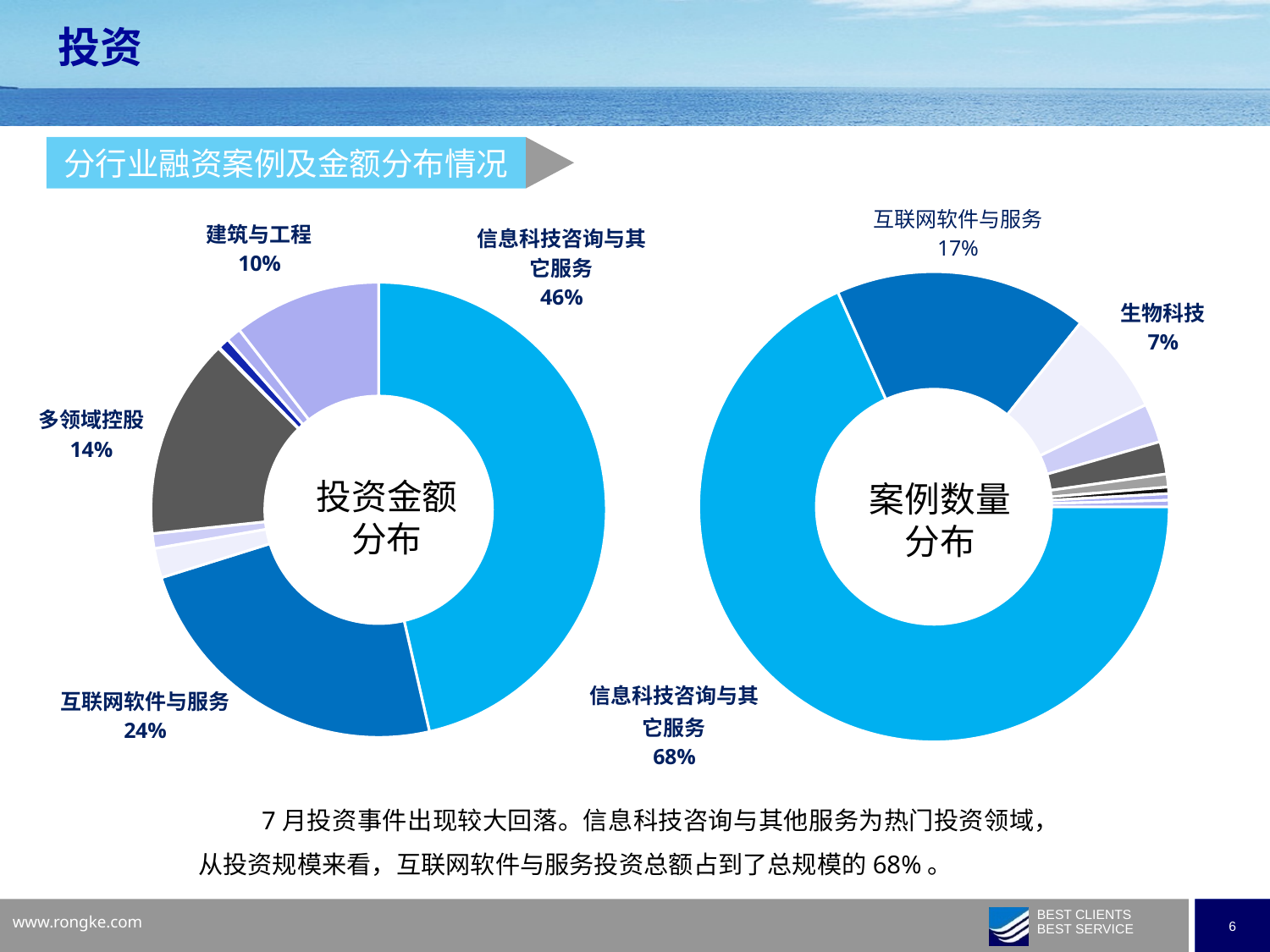
In the 投资金额分布 chart, what share does 信息科技咨询与其它服务 account for? 46% In the 案例数量分布 chart, what share does 生物科技 account for? 7% In the 案例数量分布 chart, what share does 信息科技咨询与其它服务 account for? 68% In the 投资金额分布 chart, what is the difference in percentage points between 信息科技咨询与其它服务 and 互联网软件与服务? 22 percentage points In the 投资金额分布 chart, which labeled category has the largest share? 信息科技咨询与其它服务 Which is larger: the share of 互联网软件与服务 in the 投资金额分布 chart or in the 案例数量分布 chart? 投资金额分布 In the 案例数量分布 chart, which labeled category has the smallest share? 生物科技 In the 案例数量分布 chart, what share does 互联网软件与服务 account for? 17% In the 投资金额分布 chart, what share does 互联网软件与服务 account for? 24% In the 投资金额分布 chart, what share does 建筑与工程 account for? 10% What type of chart is used for 案例数量分布? Pie (donut) chart In the 投资金额分布 chart, what share does 多领域控股 account for? 14%